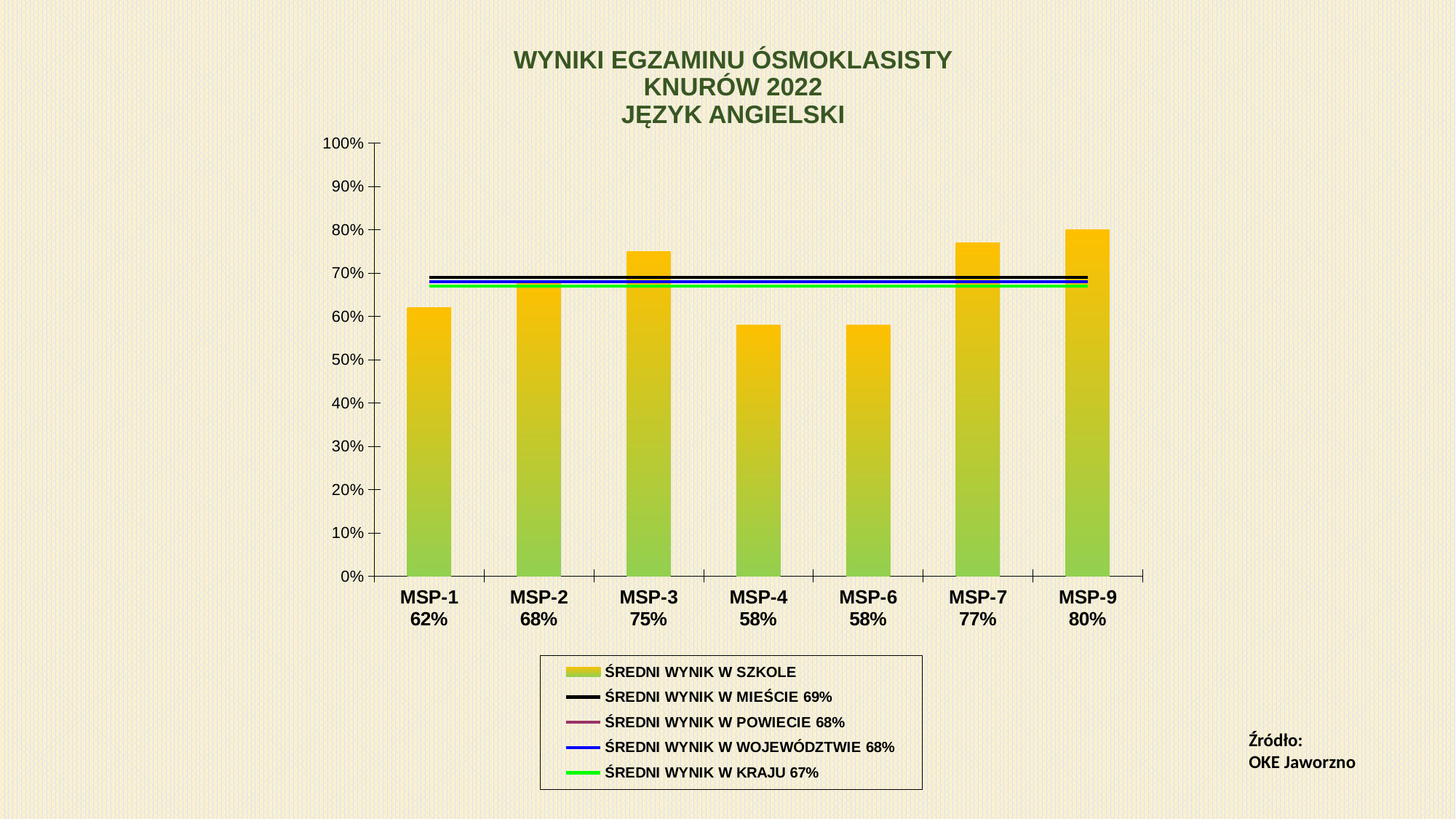
What is the average result in the city (ŚREDNI WYNIK W MIEŚCIE) according to the legend? 69% What is the difference between the results of MSP-9 and MSP-4? 22% What is the average result in the country (ŚREDNI WYNIK W KRAJU) according to the legend? 67% What is the source cited on the slide? OKE Jaworzno Which school has the highest average result? MSP-9 What kind of chart is this? combination bar and line chart What is the average school result for MSP-3? 75% What is the average school result for MSP-1? 62% How many series does the legend list? 5 Is the value for MSP-7 greater or less than 70%? greater Which is larger, the result for MSP-2 or the result for MSP-7? MSP-7 How many schools are shown on the x axis? 7